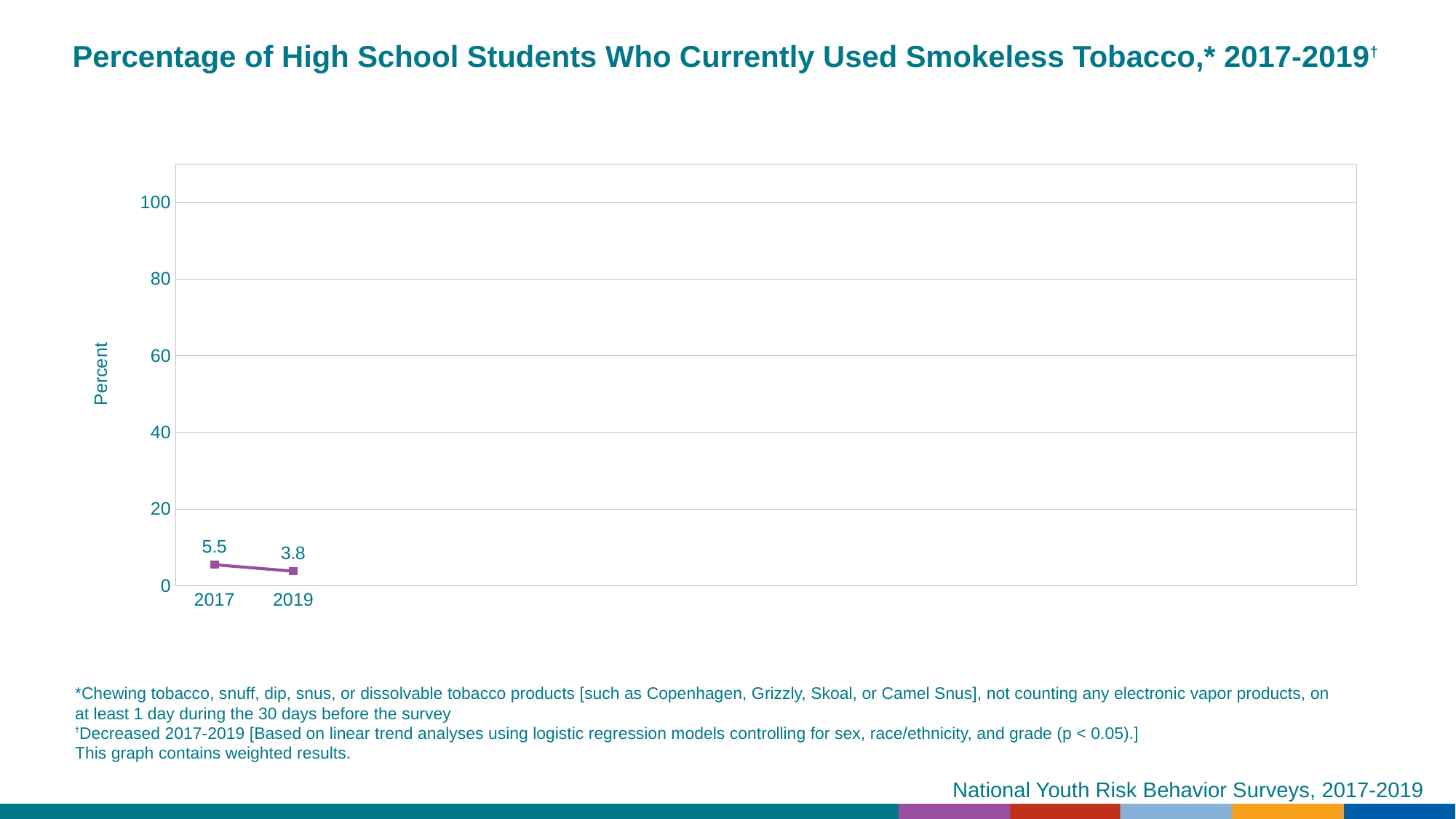
What is the label on the y axis? Percent What is the value for 2019? 3.8 What kind of chart is shown? line chart Is the value for 2017 larger or smaller than the value for 2019? larger What is the highest tick value shown on the y axis? 100 Which year has the higher value? 2017 How many data points are plotted? 2 What is the value for 2017? 5.5 Is the value for 2019 greater or less than 20? less What is the difference between the 2017 and 2019 values? 1.7 Which year has the lower value? 2019 Do the values rise or fall from 2017 to 2019? fall